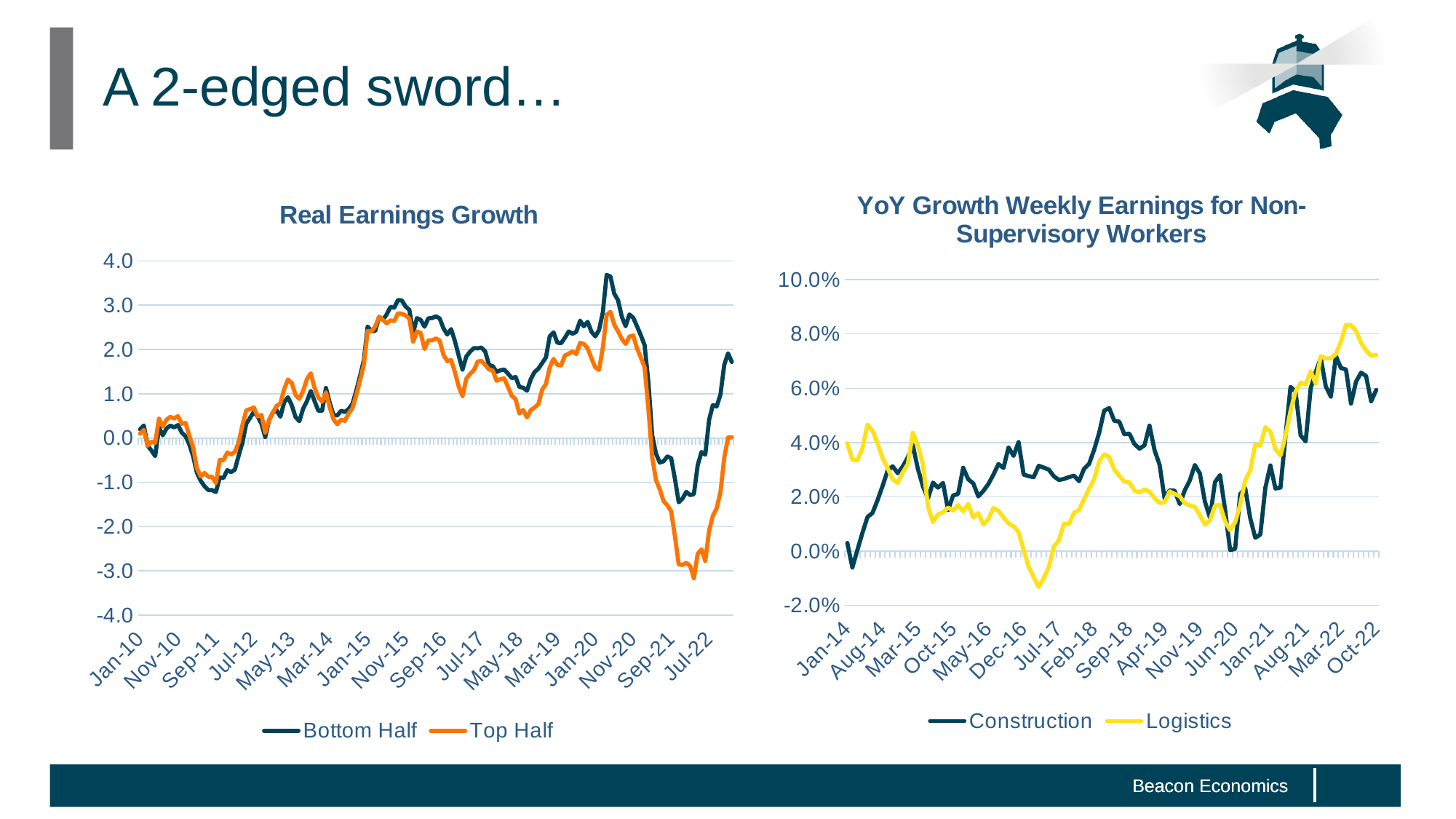
In the 'Real Earnings Growth' chart, at the Jan-20 peak, which series is higher, Bottom Half or Top Half? Bottom Half What kind of chart is the 'Real Earnings Growth' chart on the left? line chart In the 'Real Earnings Growth' chart, is the Bottom Half value at Jan-15 greater or less than 2.0? greater In the 'YoY Growth Weekly Earnings for Non-Supervisory Workers' chart, does the Logistics series rise or fall between Jul-17 and Feb-18? rise In the 'Real Earnings Growth' chart, is the peak value of Bottom Half around Jan-20 greater or less than 3.0? greater In the 'Real Earnings Growth' chart, do both series rise or fall between Nov-20 and Sep-21? fall How many series does the legend of the 'Real Earnings Growth' chart list? 2 What are the two series named in the legend of the 'YoY Growth Weekly Earnings for Non-Supervisory Workers' chart? Construction and Logistics In the 'Real Earnings Growth' chart, which series is drawn in orange? Top Half In the 'YoY Growth Weekly Earnings for Non-Supervisory Workers' chart, which series is higher at Jul-17, Construction or Logistics? Construction